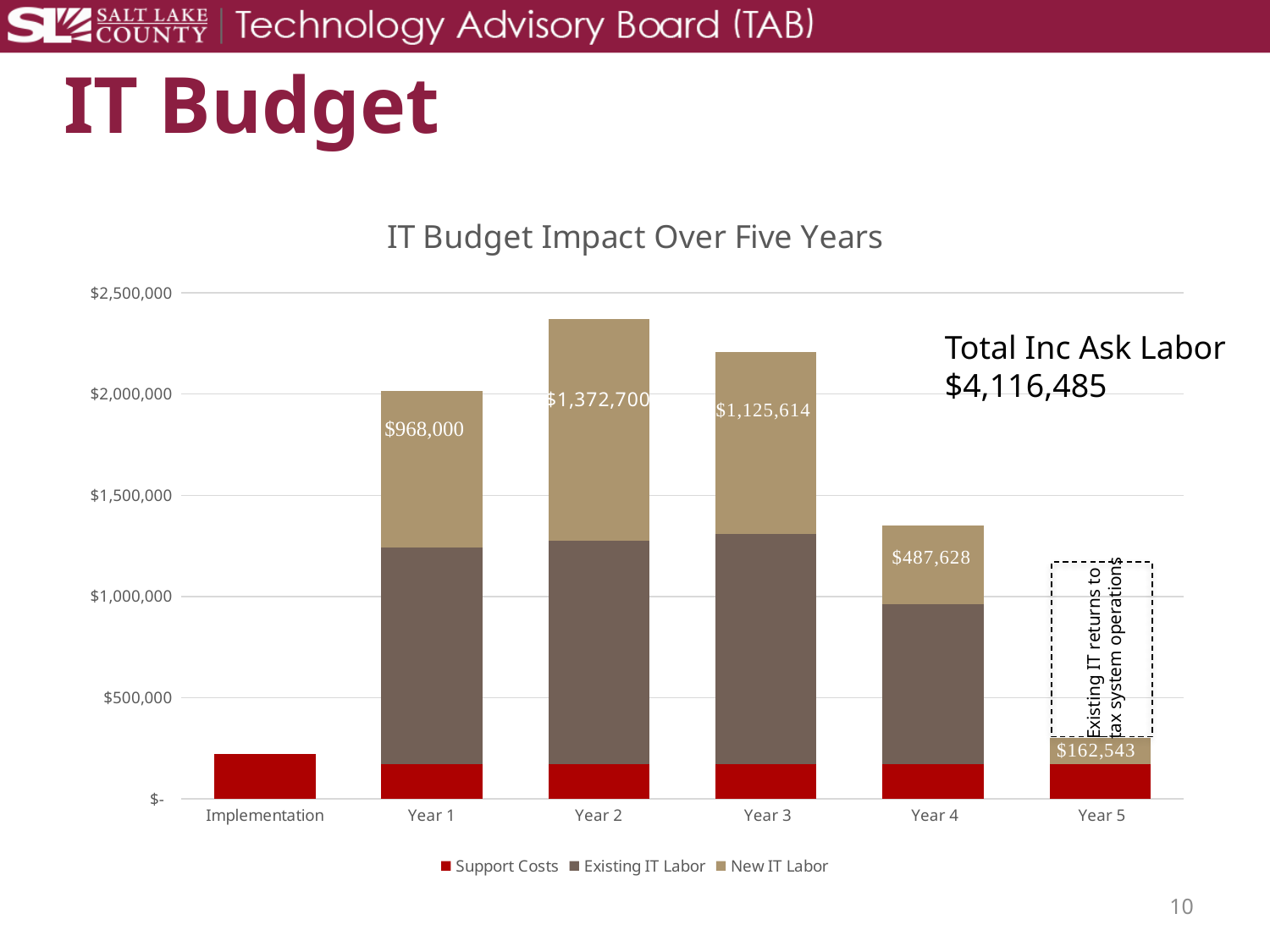
Which is larger, the New IT Labor value for Year 1 or for Year 3? Year 3 What is the difference between the New IT Labor values for Year 2 and Year 1? $404,700 How many series does the legend list? 3 Is the value for Implementation greater or less than $500,000? less What kind of chart is shown on the slide? Stacked bar chart Which year has the highest labeled New IT Labor value? Year 2 What is the value of the New IT Labor segment for Year 5? $162,543 What is the value of the New IT Labor segment for Year 1? $968,000 How many categories are shown on the x axis? 6 What is the value of the New IT Labor segment for Year 2? $1,372,700 Which year has the lowest labeled New IT Labor value? Year 5 Is the total stacked value for Year 2 greater or less than $2,000,000? greater